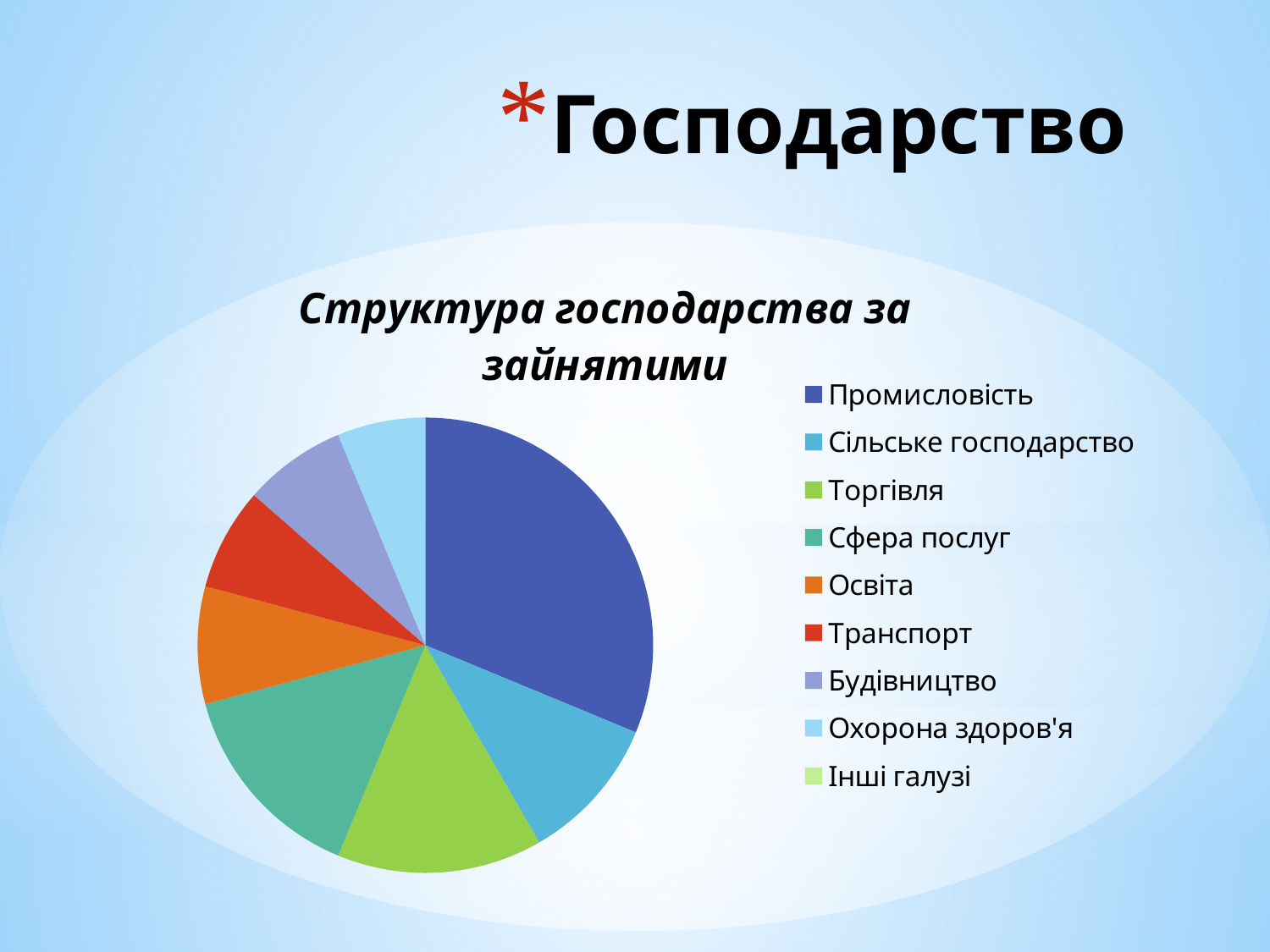
How many entries does the chart legend list? 9 What is the title of the chart? Структура господарства за зайнятими Which slice is larger, Торгівля or Будівництво? Торгівля Which slice is larger, Сільське господарство or Охорона здоров'я? Сільське господарство Which category has the largest slice of the pie? Промисловість Which slice is larger, Промисловість or Охорона здоров'я? Промисловість What kind of chart is shown on the slide? pie chart Which colour represents Освіта in the chart? orange